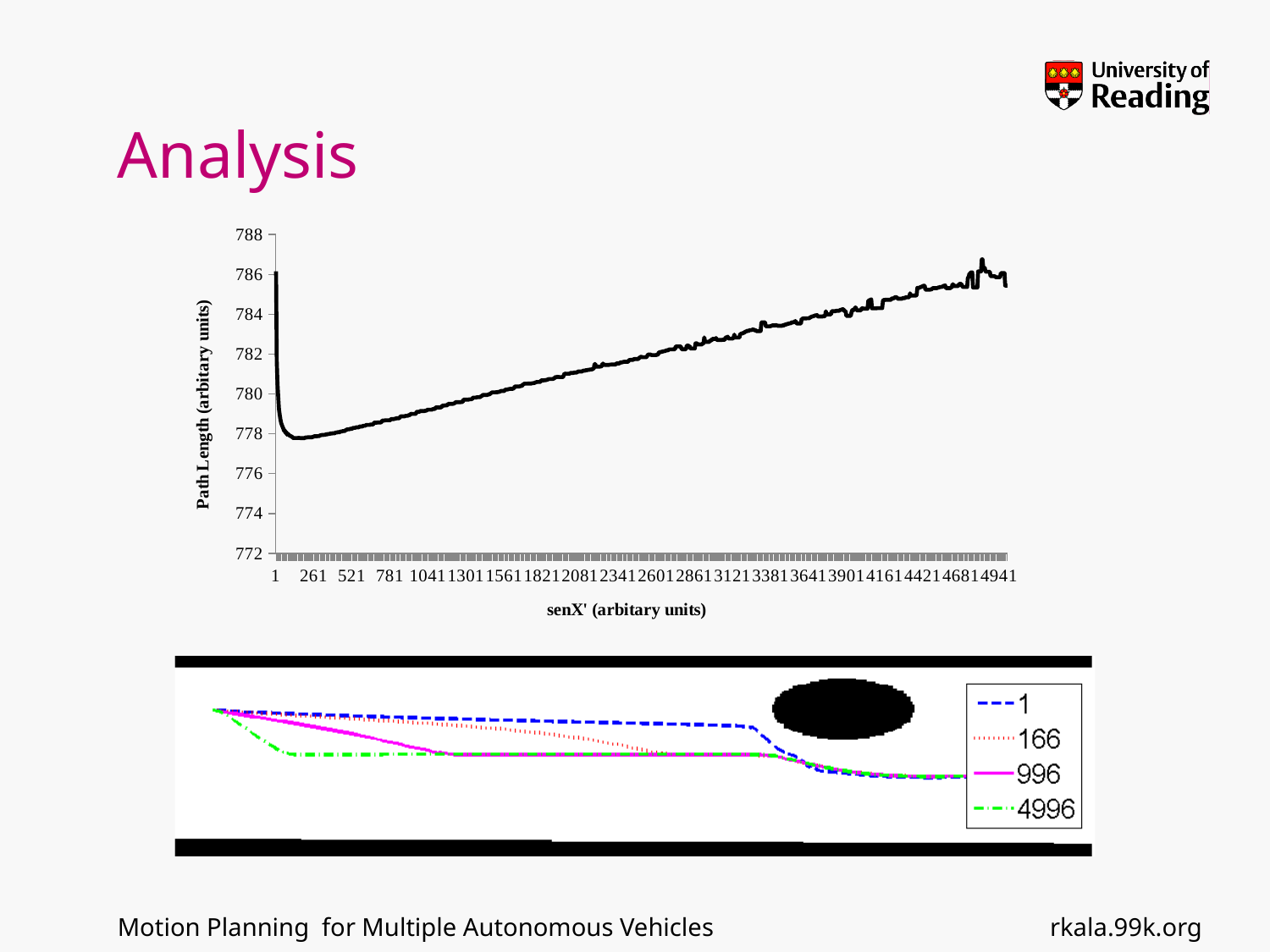
What is the label of the x-axis on the top chart? senX' (arbitary units) On the top chart, is the path length at senX' = 1 greater or less than 784? greater On the top chart, is the path length at senX' = 1 greater or less than the path length at senX' = 1041? greater What is the label of the y-axis on the top chart? Path Length (arbitary units) What is the highest tick value shown on the y-axis of the top chart? 788 On the top chart, is the path length at senX' = 2601 greater or less than 780? greater How many lines (series) are plotted on the top chart? 1 How many entries does the legend of the bottom figure list? 4 On the top chart, is the path length at senX' = 4941 greater or less than 784? greater On the top chart, does the path length rise or fall as senX' increases from 261 to 4941? rise What kind of chart is the top chart on the slide? line chart